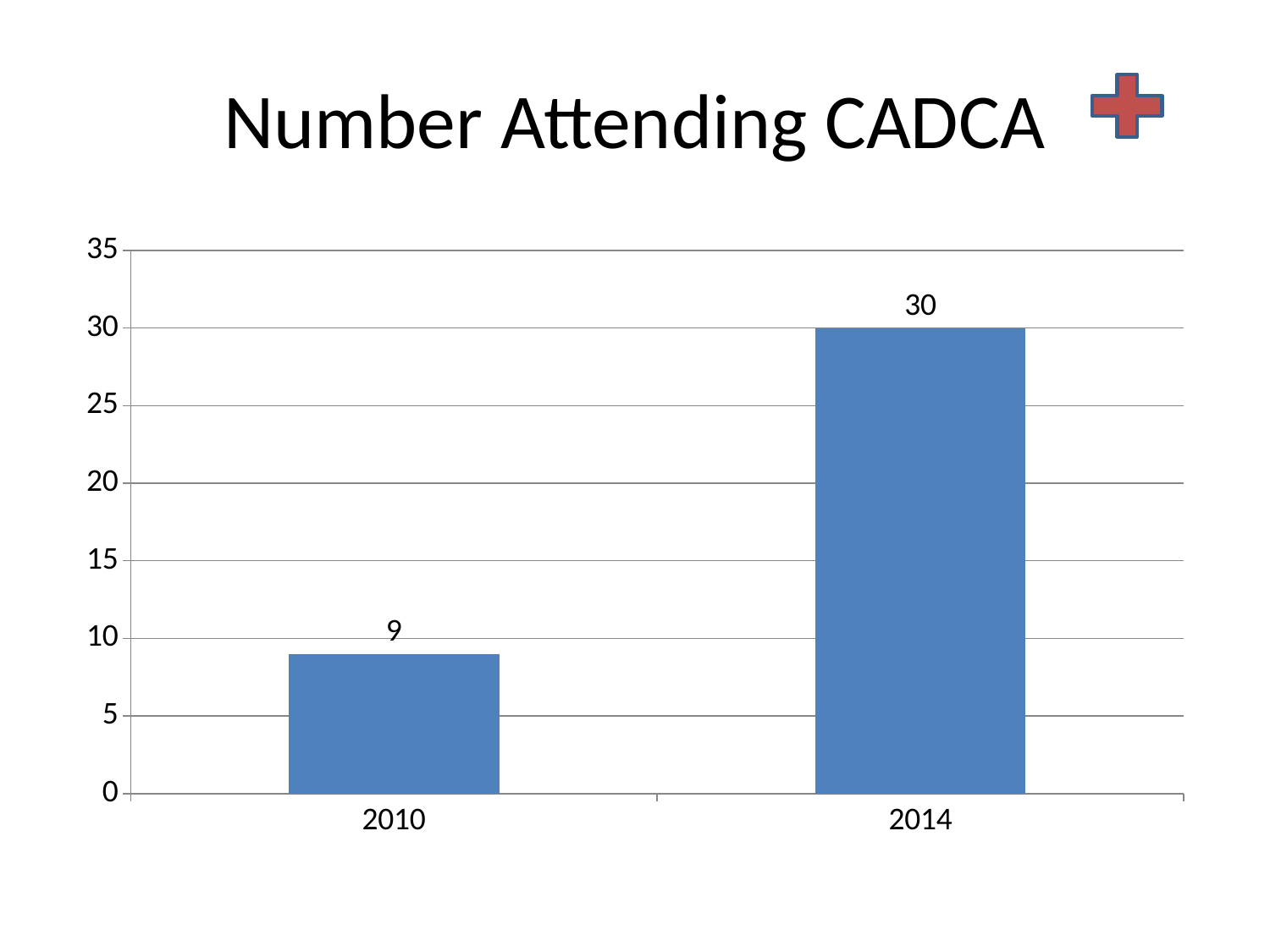
What is the title of the slide? Number Attending CADCA Which year has the highest number attending CADCA? 2014 Is the value for 2014 greater or less than 25? greater What is the number attending CADCA in 2010? 9 How many years are shown on the chart? 2 Which year has the lowest number attending CADCA? 2010 What kind of chart is shown on the slide? bar chart Is the value for 2010 greater or less than 10? less Which is larger, the value for 2010 or the value for 2014? 2014 What is the number attending CADCA in 2014? 30 What is the difference between the number attending in 2014 and in 2010? 21 Do the values rise or fall from 2010 to 2014? rise